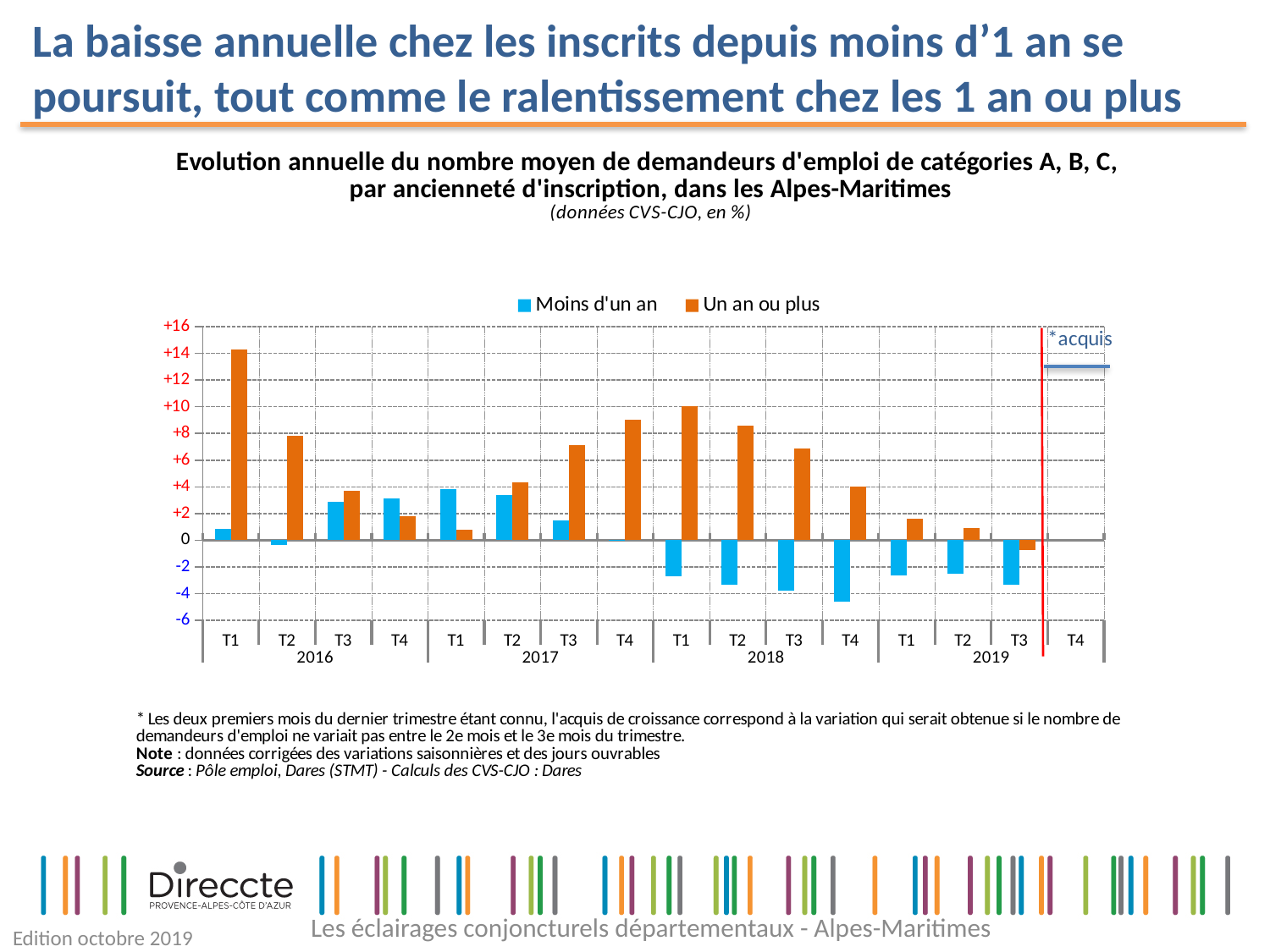
What kind of chart is shown on the slide? bar chart Which is larger: the 'Un an ou plus' value in T1 2016 or in T2 2016? T1 2016 Do the 'Un an ou plus' values rise or fall from T1 to T4 of 2016? fall Which series is shown in blue in the legend? Moins d'un an Is the value for 'Moins d'un an' in T4 2018 greater or less than -4? less In which quarter is the value for 'Un an ou plus' the highest? T1 2016 Is the value for 'Un an ou plus' in T1 2016 greater or less than +12? greater Is the value for 'Un an ou plus' in T1 2018 greater or less than +8? greater How many years are labelled along the x axis? 4 Do the 'Moins d'un an' values rise or fall from T1 to T4 of 2018? fall How many series does the legend list? 2 In which quarter is the value for 'Moins d'un an' the lowest? T4 2018